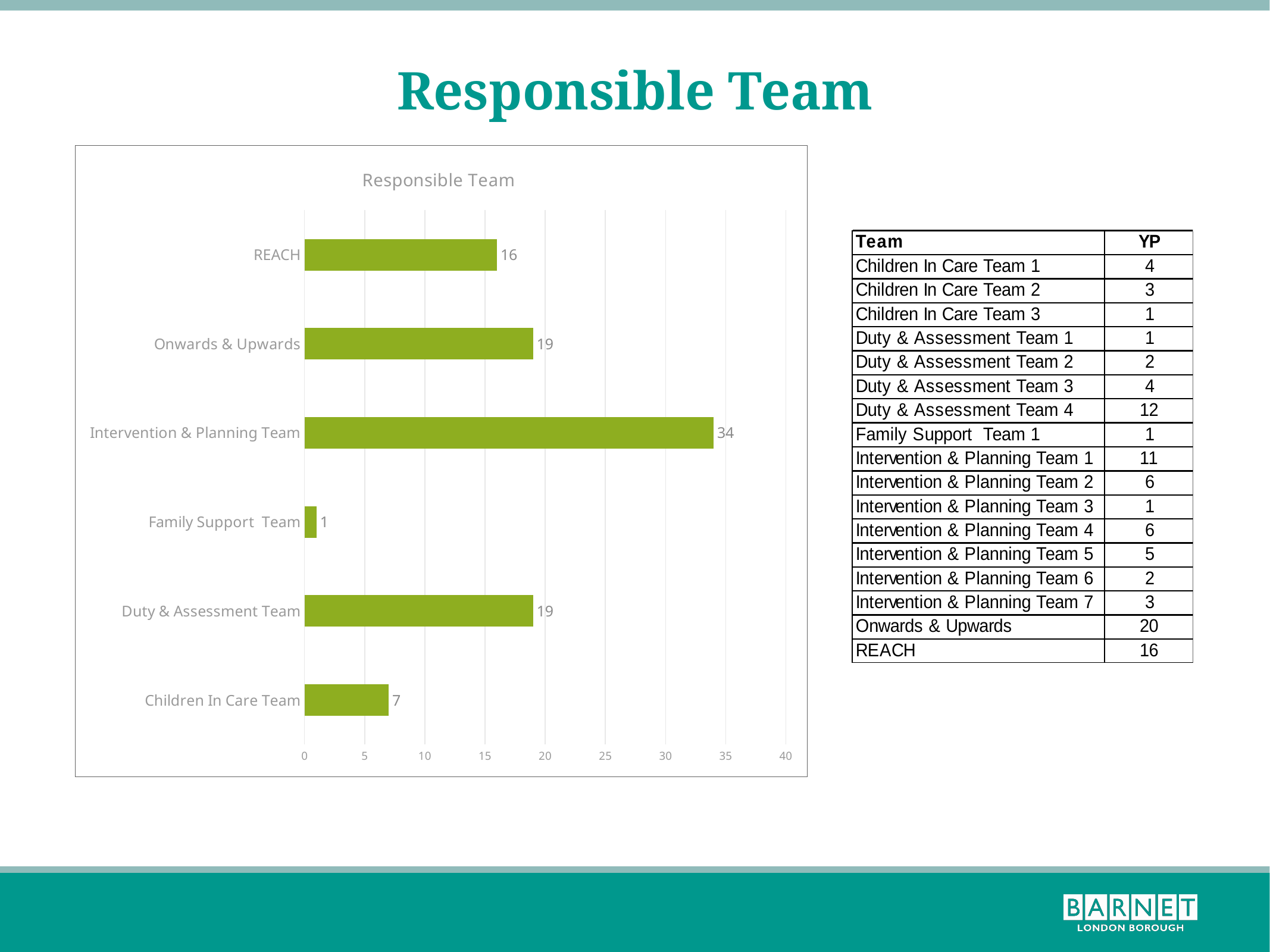
Which is larger in the chart, the value for REACH or the value for Children In Care Team? REACH What is the value for REACH in the chart? 16 Which team has the highest value in the chart? Intervention & Planning Team What is the value for Children In Care Team in the chart? 7 What is the title of the chart? Responsible Team What is the value for Family Support Team in the chart? 1 Which team has the lowest value in the chart? Family Support Team How many teams are shown in the chart? 6 What is the value for Intervention & Planning Team in the chart? 34 Is the value for Duty & Assessment Team in the chart greater or less than 15? greater What kind of chart is shown on the slide? Bar chart What is the difference between the values for Intervention & Planning Team and Onwards & Upwards in the chart? 15